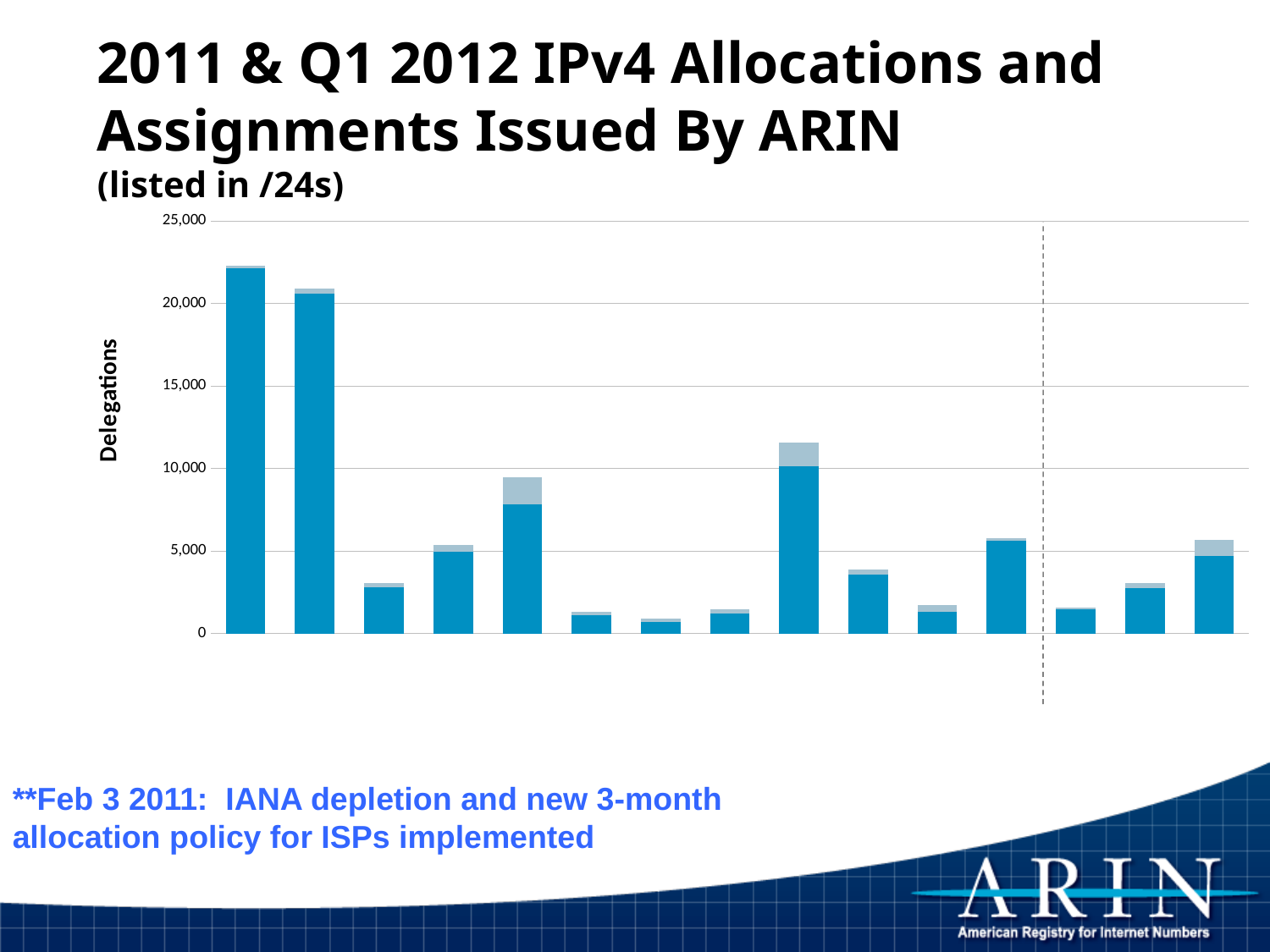
What is the label on the vertical axis of the chart? Delegations Which bar is the tallest in the chart? the first (leftmost) bar Is the value of the third bar from the left greater or less than 5,000? less Do the values rise or fall from the first bar to the third bar? fall How many bars are plotted in the chart? 15 Is the value of the ninth bar from the left greater or less than 10,000? greater Is the value of the last (rightmost) bar greater or less than 10,000? less What kind of chart is shown on the slide? bar chart In what units are the values listed, according to the chart's subtitle? /24s Which is larger, the first bar or the second bar? the first bar Which bar is the shortest in the chart? the seventh bar from the left